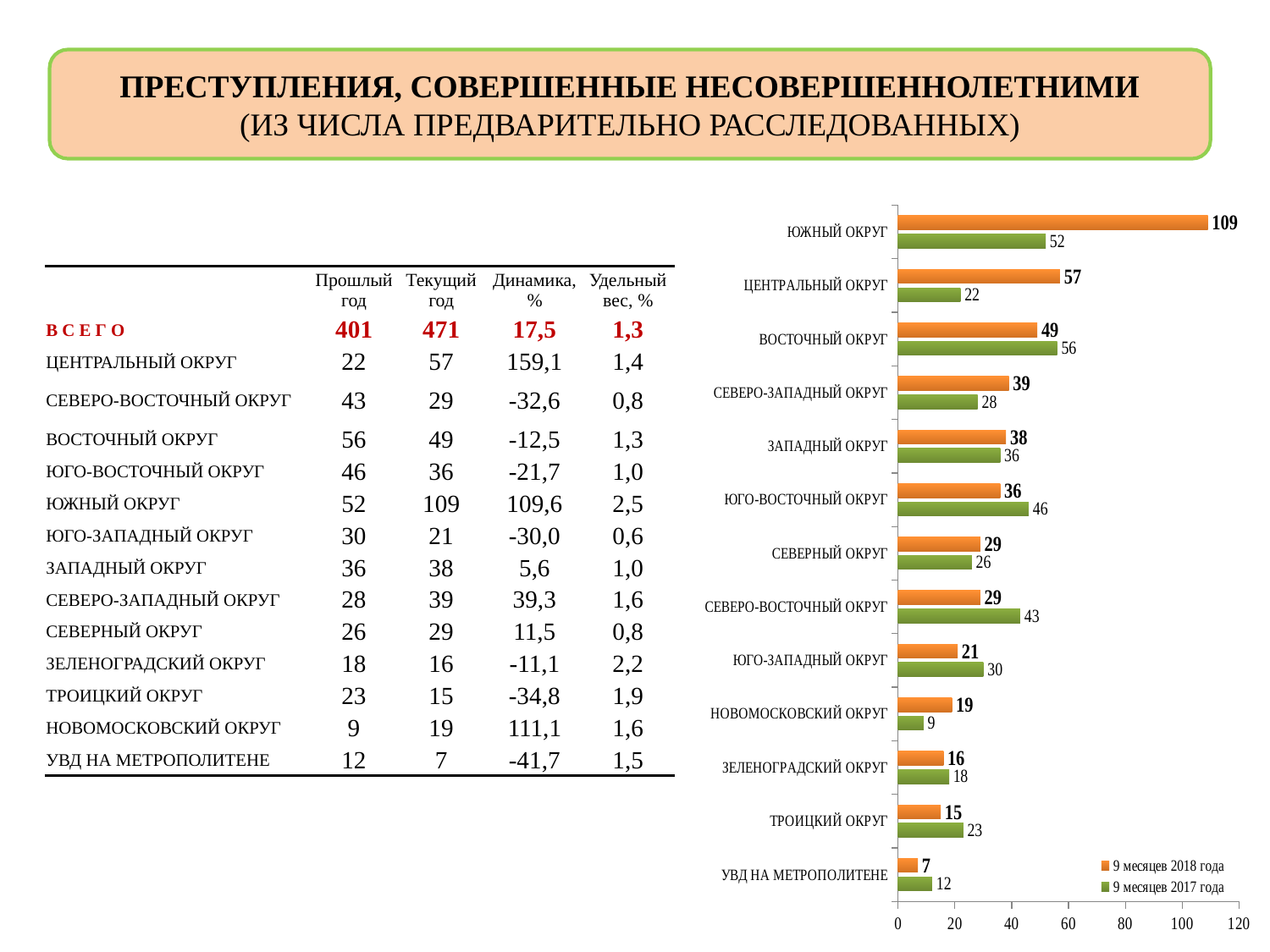
Which district has the highest value in the series 9 месяцев 2018 года? ЮЖНЫЙ ОКРУГ What is the difference between the 9 месяцев 2018 года and 9 месяцев 2017 года values for ЮЖНЫЙ ОКРУГ? 57 What is the value for ЦЕНТРАЛЬНЫЙ ОКРУГ in the series 9 месяцев 2017 года? 22 Is the value for СЕВЕРО-ЗАПАДНЫЙ ОКРУГ in the series 9 месяцев 2018 года greater or less than 20? greater What is the value for НОВОМОСКОВСКИЙ ОКРУГ in the series 9 месяцев 2017 года? 9 How many districts (categories) are shown in the chart? 13 What is the value for ЮЖНЫЙ ОКРУГ in the series 9 месяцев 2018 года? 109 For ВОСТОЧНЫЙ ОКРУГ, which series has the larger value: 9 месяцев 2018 года or 9 месяцев 2017 года? 9 месяцев 2017 года What kind of chart is shown on the slide? bar chart Which district has the lowest value in the series 9 месяцев 2018 года? УВД НА МЕТРОПОЛИТЕНЕ Which colour represents the series 9 месяцев 2017 года in the chart? green How many series does the chart legend list? 2